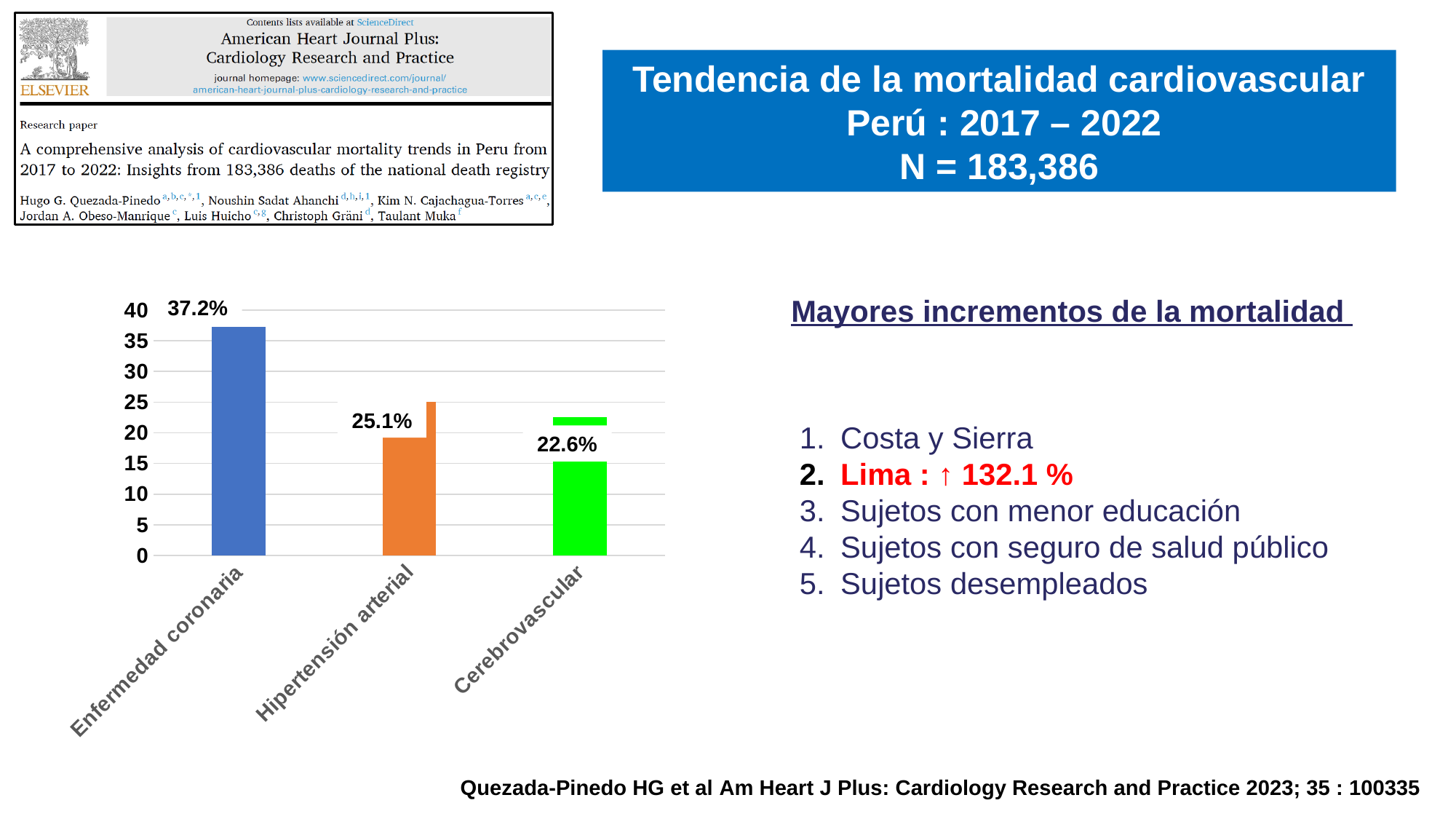
What is the value shown for Hipertensión arterial? 25.1% Which category has the lowest value? Cerebrovascular What kind of chart is shown on the slide? bar chart What colour is the bar for Cerebrovascular? green What is the difference between the values for Enfermedad coronaria and Hipertensión arterial? 12.1% What is the value shown for Cerebrovascular? 22.6% How many categories are shown in the chart? 3 Which category has the highest value? Enfermedad coronaria Which is larger, the value for Hipertensión arterial or the value for Cerebrovascular? Hipertensión arterial What is the value shown for Enfermedad coronaria? 37.2% Is the value for Enfermedad coronaria greater or less than 30? greater What is the difference between the values for Enfermedad coronaria and Cerebrovascular? 14.6%